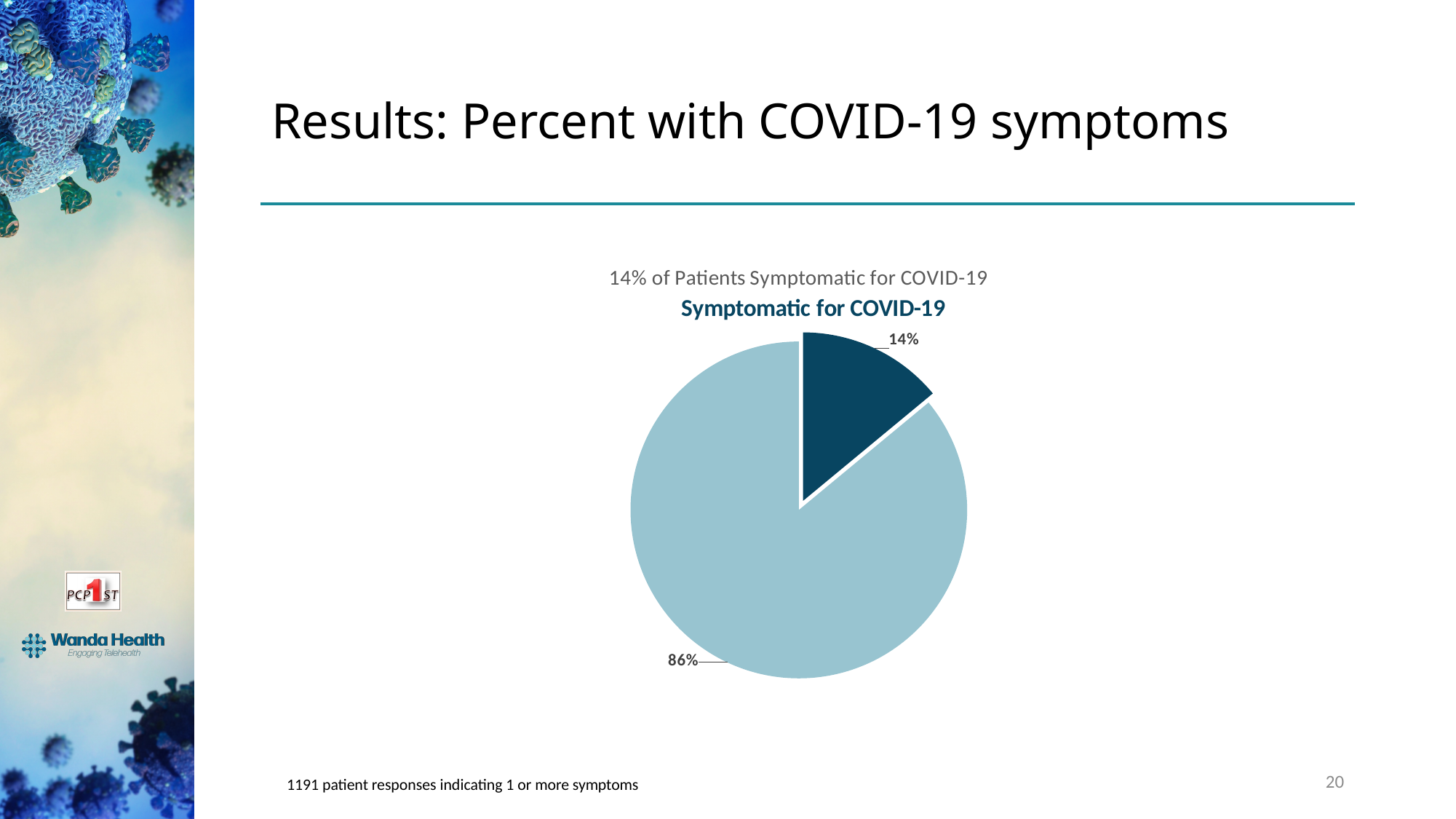
What percentage of patients were symptomatic for COVID-19 according to the chart? 14% What is the difference between the two slices of the pie chart? 72% What share of the pie is the light blue slice? 86% Which slice is the largest in the pie chart? 86% Is the value of the light blue slice greater or less than 50%? greater What kind of chart is shown on the slide? pie chart What share of the pie is the dark blue slice? 14% What is the title of the chart? Symptomatic for COVID-19 Which slice is the smallest in the pie chart? 14% Is the dark blue slice larger or smaller than the light blue slice? smaller How many slices does the pie chart have? 2 What colour is the slice representing 14%? dark blue